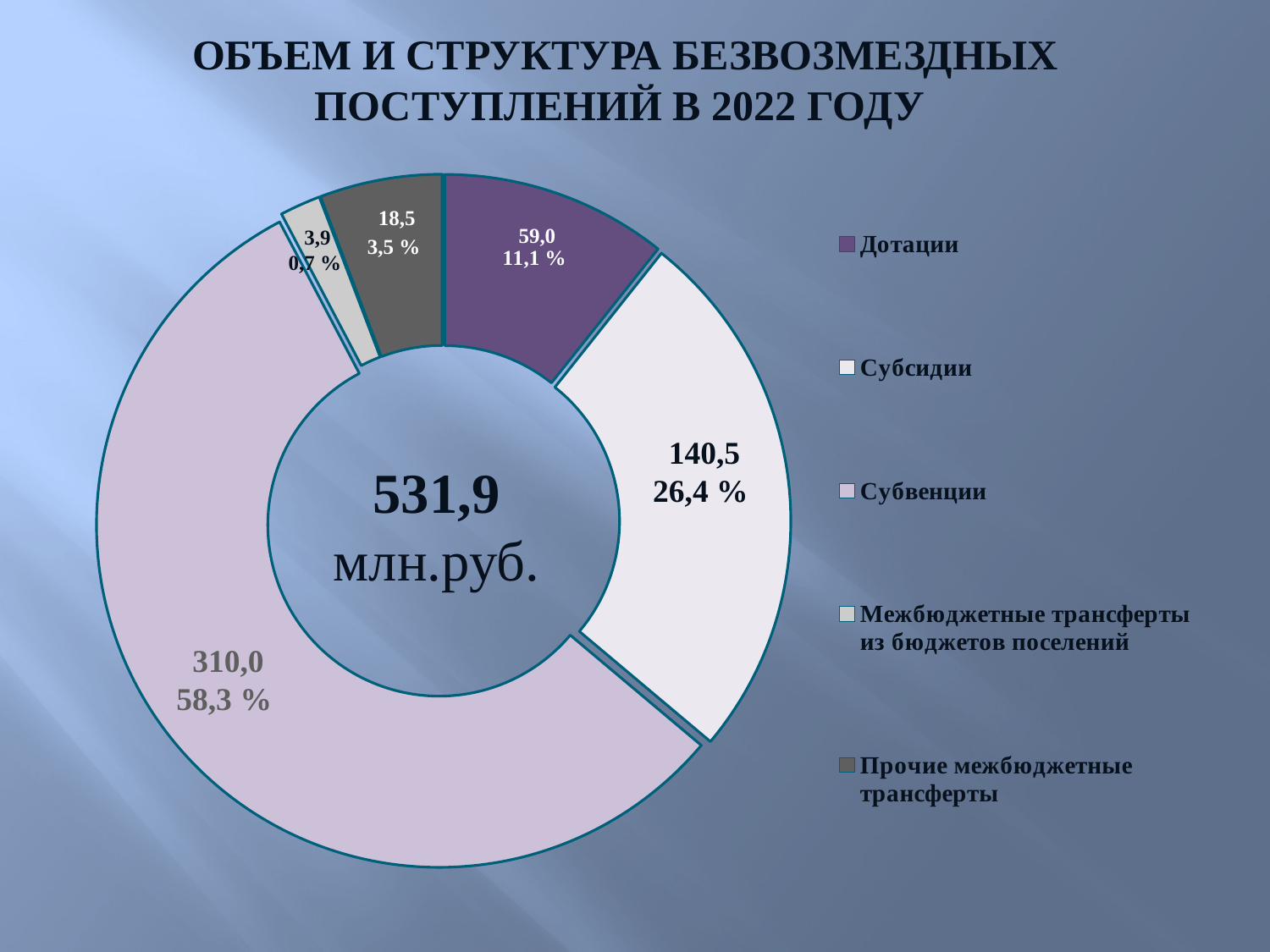
What share of the total do Субсидии make up? 26,4 % What kind of chart is shown on the slide? Doughnut (pie) chart What share of the total do Прочие межбюджетные трансферты make up? 3,5 % What total is printed in the centre of the chart? 531,9 млн.руб. What is the title of the slide? ОБЪЕМ И СТРУКТУРА БЕЗВОЗМЕЗДНЫХ ПОСТУПЛЕНИЙ В 2022 ГОДУ Which is larger, the value for Дотации or the value for Прочие межбюджетные трансферты? Дотации Which category has the largest value? Субвенции What is the value shown for Дотации? 59,0 What is the difference between the values for Субвенции and Субсидии? 169,5 Which category has the smallest value? Межбюджетные трансферты из бюджетов поселений What is the value shown for Субвенции? 310,0 How many categories does the chart show? 5